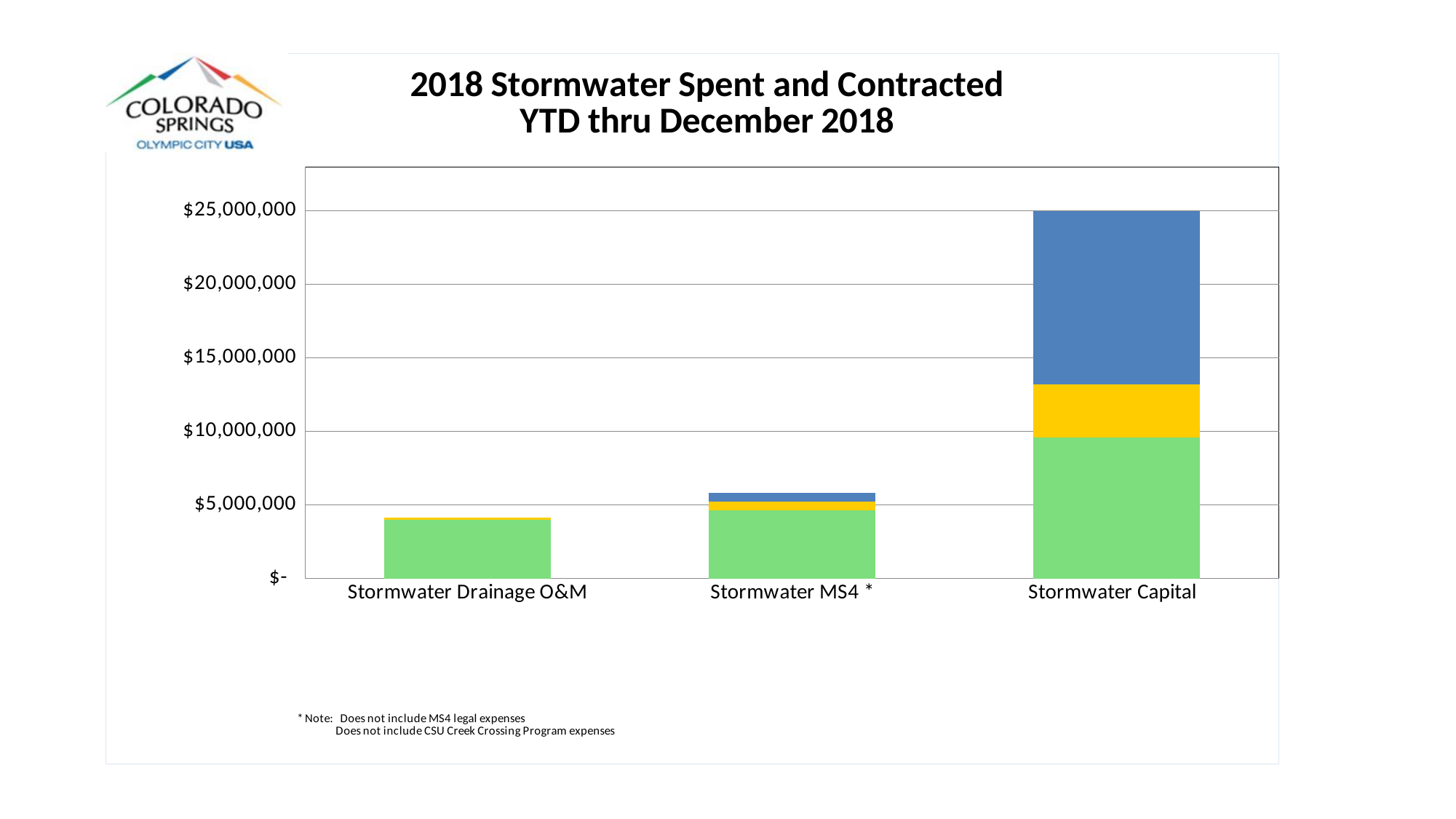
Is the green segment of the Stormwater Capital bar greater or less than $10,000,000? less What is the title of the chart? 2018 Stormwater Spent and Contracted YTD thru December 2018 Which bar is taller, Stormwater MS4 or Stormwater Drainage O&M? Stormwater MS4 Which category has the shortest bar in the chart? Stormwater Drainage O&M Is the total value for Stormwater Capital greater or less than $20,000,000? greater Is the total value for Stormwater MS4 greater or less than $5,000,000? greater Which category has the tallest bar in the chart? Stormwater Capital How many categories are shown on the x axis of the chart? 3 What kind of chart is shown on the slide? bar chart Do the bar totals rise or fall moving from left to right across the x axis? rise What is the highest value labelled on the y axis of the chart? $25,000,000